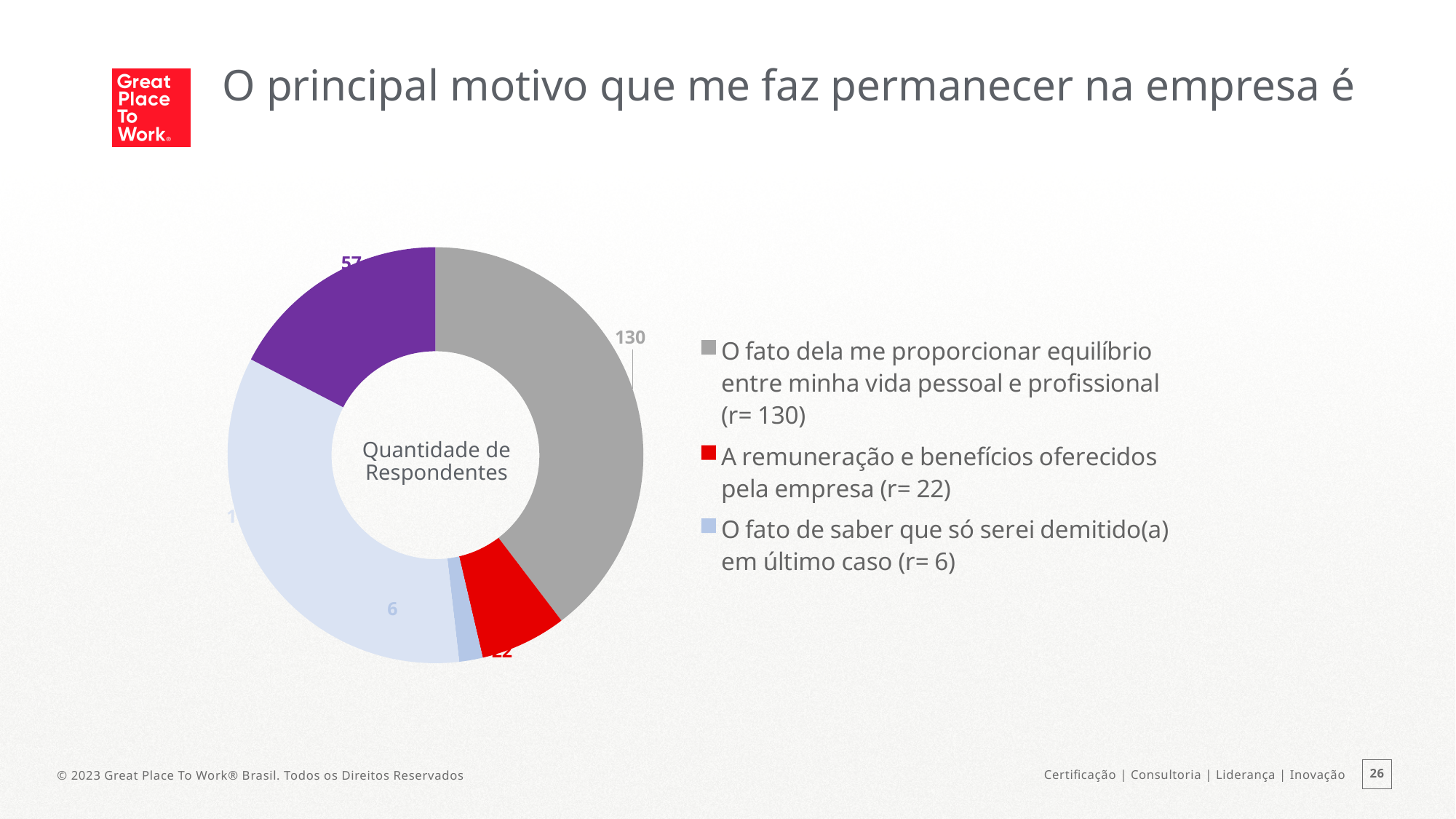
Which is larger: the value for 'A remuneração e benefícios oferecidos pela empresa' or for 'O fato dela me proporcionar equilíbrio entre minha vida pessoal e profissional'? O fato dela me proporcionar equilíbrio entre minha vida pessoal e profissional How many entries does the legend list? 3 What text appears in the centre of the donut chart? Quantidade de Respondentes What kind of chart is shown on the slide? pie chart (donut) What value is labelled on the purple slice of the chart? 57 How many respondents chose 'O fato dela me proporcionar equilíbrio entre minha vida pessoal e profissional'? 130 What is the difference between the values for 'A remuneração e benefícios oferecidos pela empresa' (22) and 'O fato de saber que só serei demitido(a) em último caso' (6)? 16 Which slice of the chart is the largest? O fato dela me proporcionar equilíbrio entre minha vida pessoal e profissional (130) What is the value for 'O fato de saber que só serei demitido(a) em último caso'? 6 What is the difference between the values for 'O fato dela me proporcionar equilíbrio entre minha vida pessoal e profissional' (130) and 'A remuneração e benefícios oferecidos pela empresa' (22)? 108 Which slice of the chart is the smallest? O fato de saber que só serei demitido(a) em último caso (6) What is the value for 'A remuneração e benefícios oferecidos pela empresa'? 22